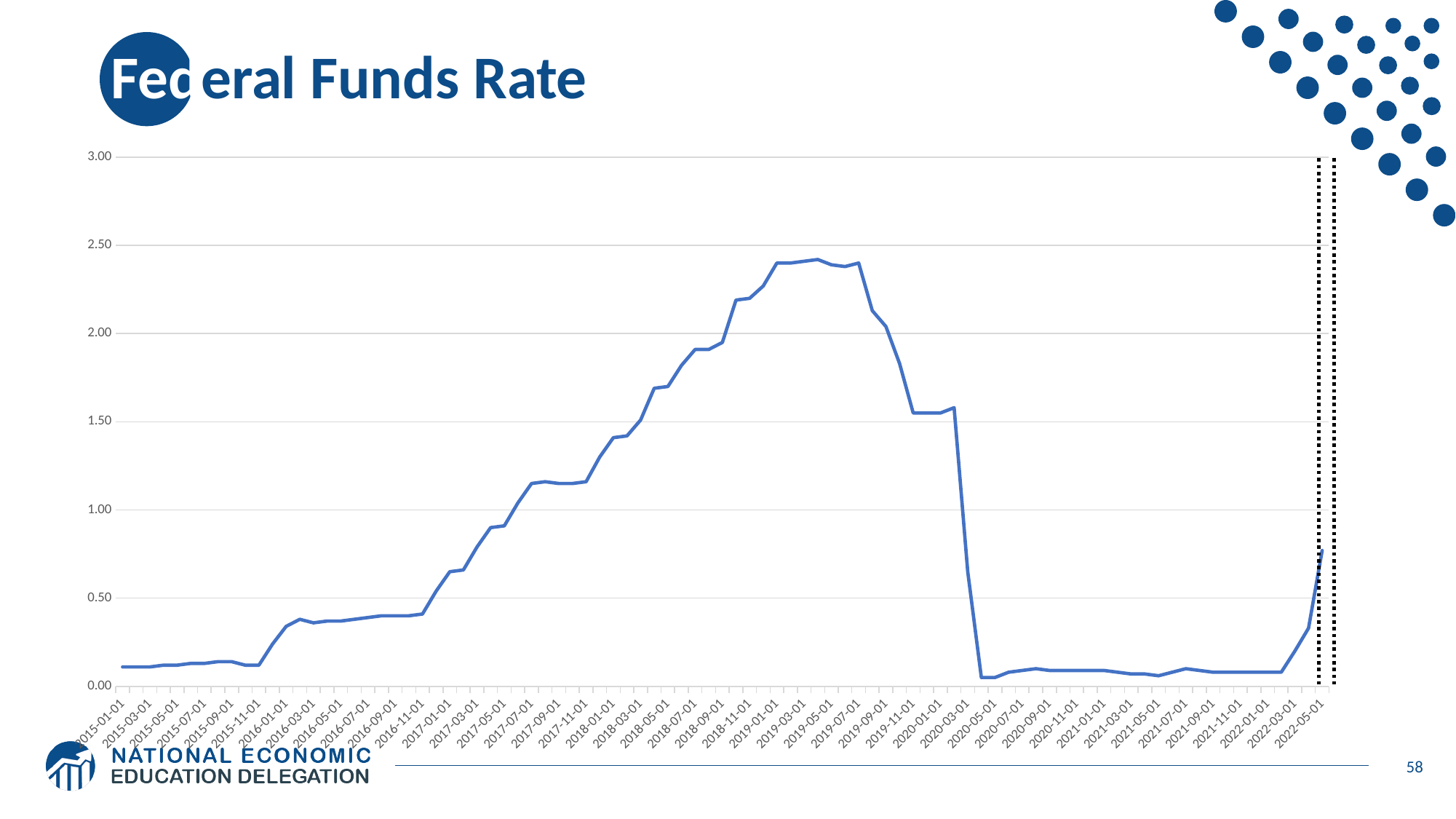
Is the value for 2018-05-01 greater or less than 1.50? greater Is the value for 2015-05-01 greater or less than 0.50? less What is the title of the chart? Federal Funds Rate Is the value for 2020-07-01 greater or less than 0.50? less Does the line rise or fall between 2017-01-01 and 2019-01-01? rise Does the line rise or fall between 2019-07-01 and 2020-05-01? fall What kind of chart is shown on the slide? line chart Which is larger, the value for 2019-03-01 or the value for 2021-01-01? 2019-03-01 What is the highest value shown on the vertical axis? 3.00